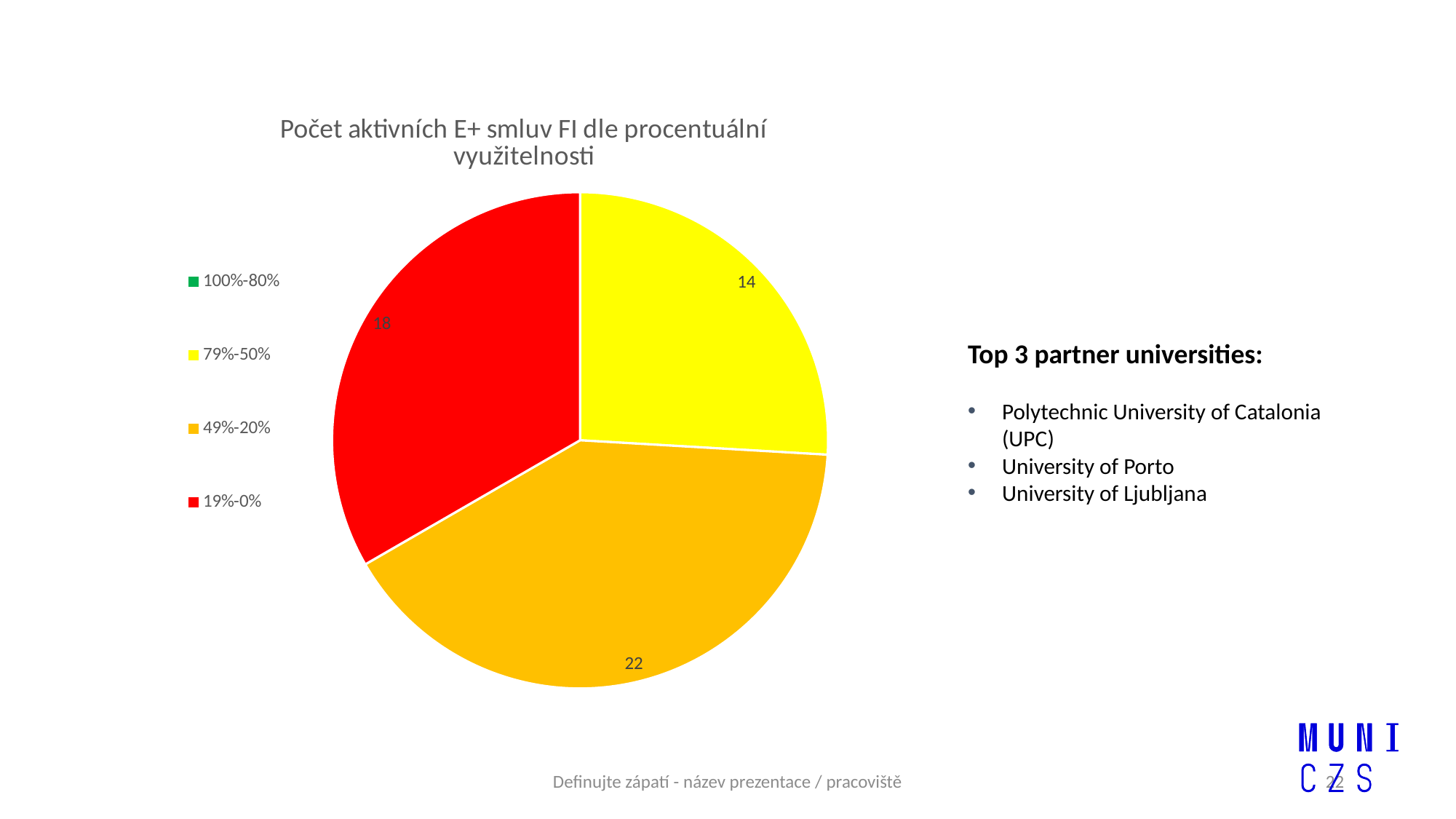
What is the value for the 79%-50% category? 14 What is the difference between the values for 19%-0% and 79%-50%? 4 Which category has the largest slice of the pie? 49%-20% What type of chart is shown on the slide? Pie chart What is the value for the 49%-20% category? 22 What colour is the slice for the 19%-0% category? Red What is the title of the chart? Počet aktivních E+ smluv FI dle procentuální využitelnosti What is the difference between the values for 49%-20% and 79%-50%? 8 What is the value for the 19%-0% category? 18 Which of the labelled slices has the smallest value? 79%-50% How many categories does the legend list? 4 Which is larger, the value for 19%-0% or the value for 79%-50%? 19%-0%